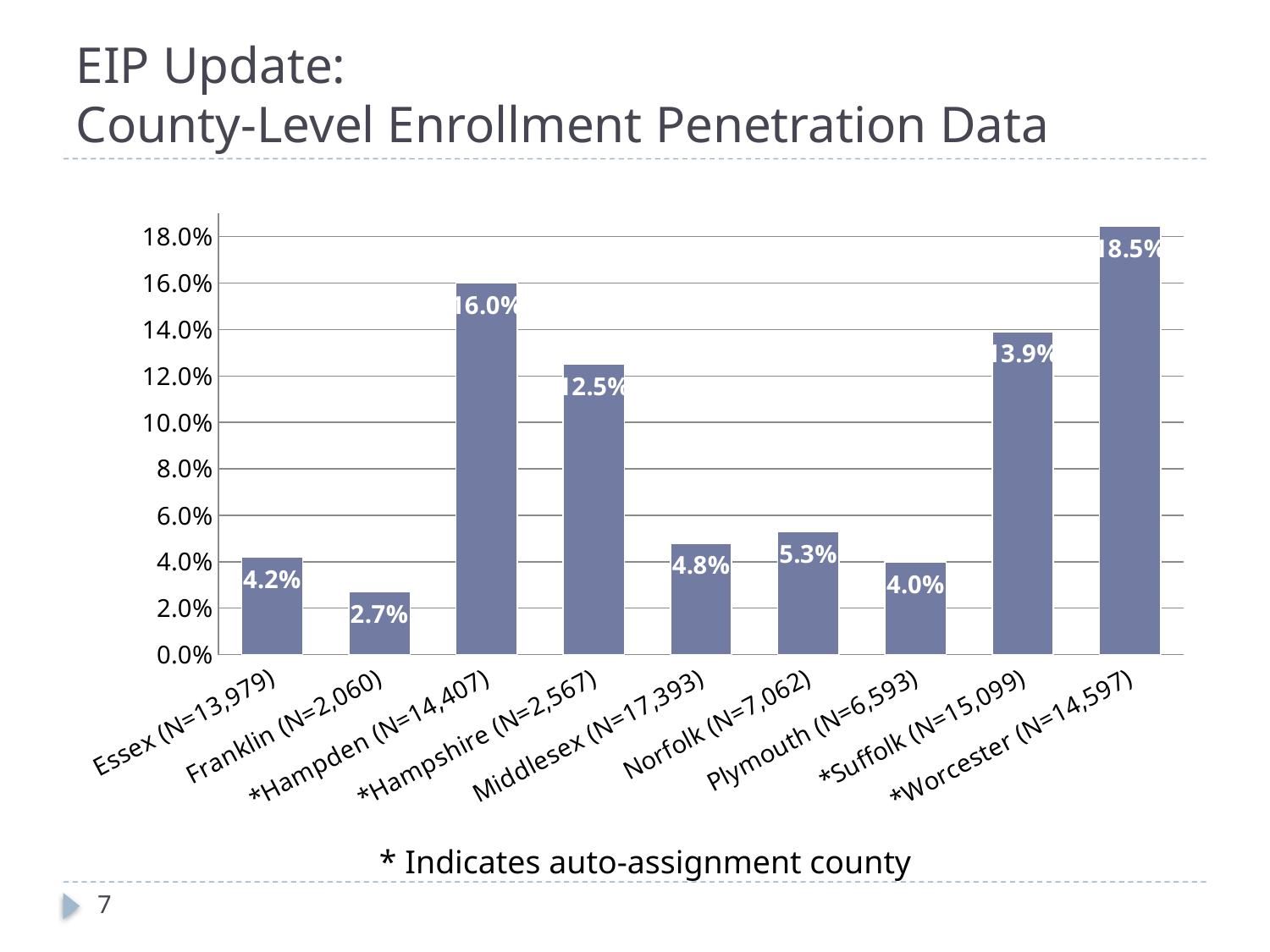
Is the value for *Suffolk (N=15,099) greater or less than 12.0%? greater Which is larger, the value for Norfolk (N=7,062) or the value for Middlesex (N=17,393)? Norfolk (N=7,062) What is the enrollment penetration value for Plymouth (N=6,593)? 4.0% What kind of chart is shown on the slide? bar chart What is the enrollment penetration value for *Hampden (N=14,407)? 16.0% What is the difference between the values for *Hampden (N=14,407) and *Hampshire (N=2,567)? 3.5% According to the note below the chart, what does an asterisk before a county name indicate? auto-assignment county Which county has the highest enrollment penetration? *Worcester (N=14,597) How many counties are shown in the chart? 9 Which county has the lowest enrollment penetration? Franklin (N=2,060) What is the difference between the values for *Worcester (N=14,597) and Franklin (N=2,060)? 15.8% What is the enrollment penetration value for Essex (N=13,979)? 4.2%